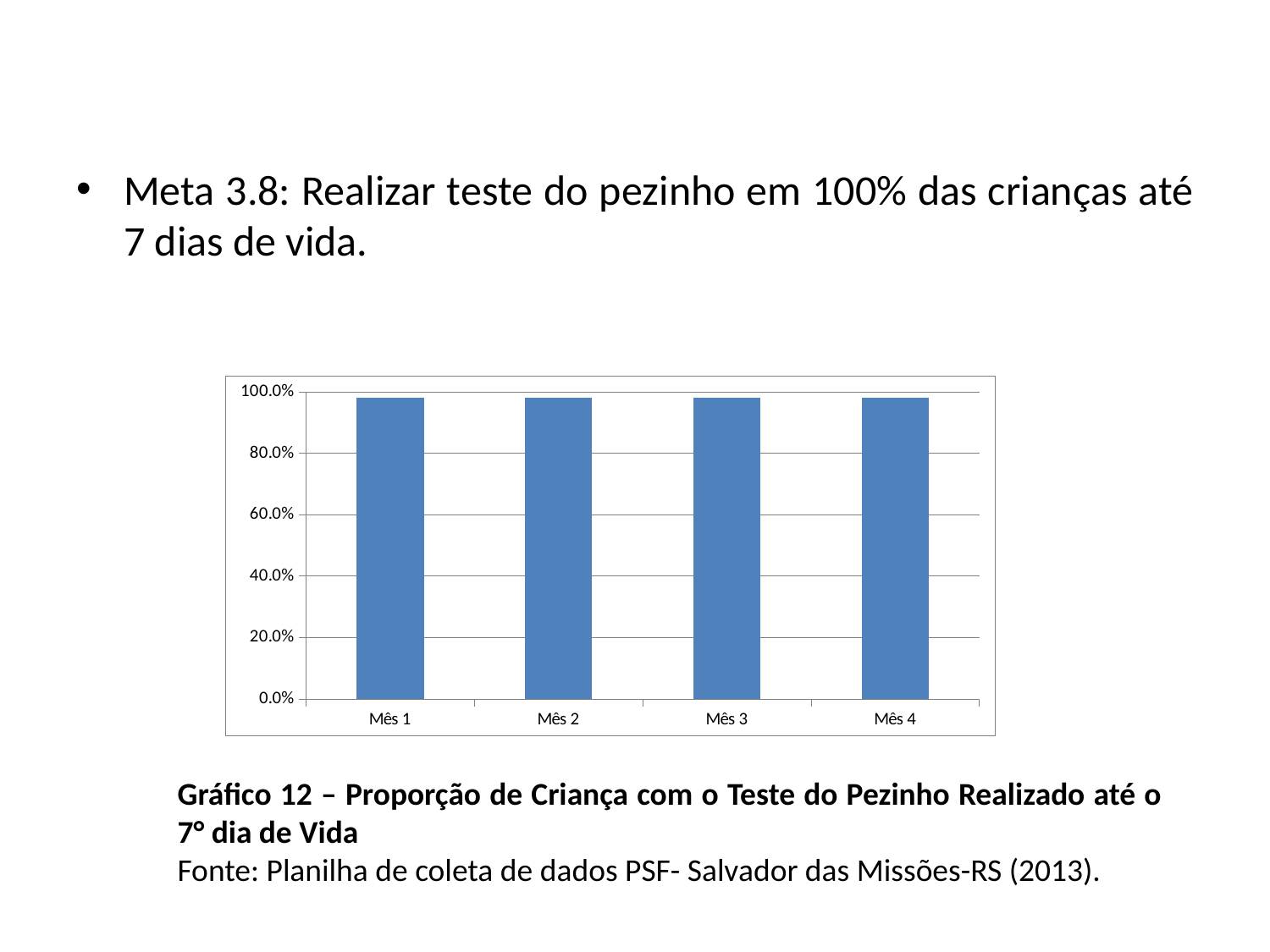
How many categories (months) are shown on the x axis of the chart? 4 Is the value for Mês 3 greater or less than 80.0%? greater What is the label of the first category on the x axis? Mês 1 Is the value for Mês 1 greater or less than 80.0%? greater What kind of chart is shown on the slide? bar chart Is the value for Mês 4 greater or less than 40.0%? greater What is the highest tick value shown on the y axis of the chart? 100.0%